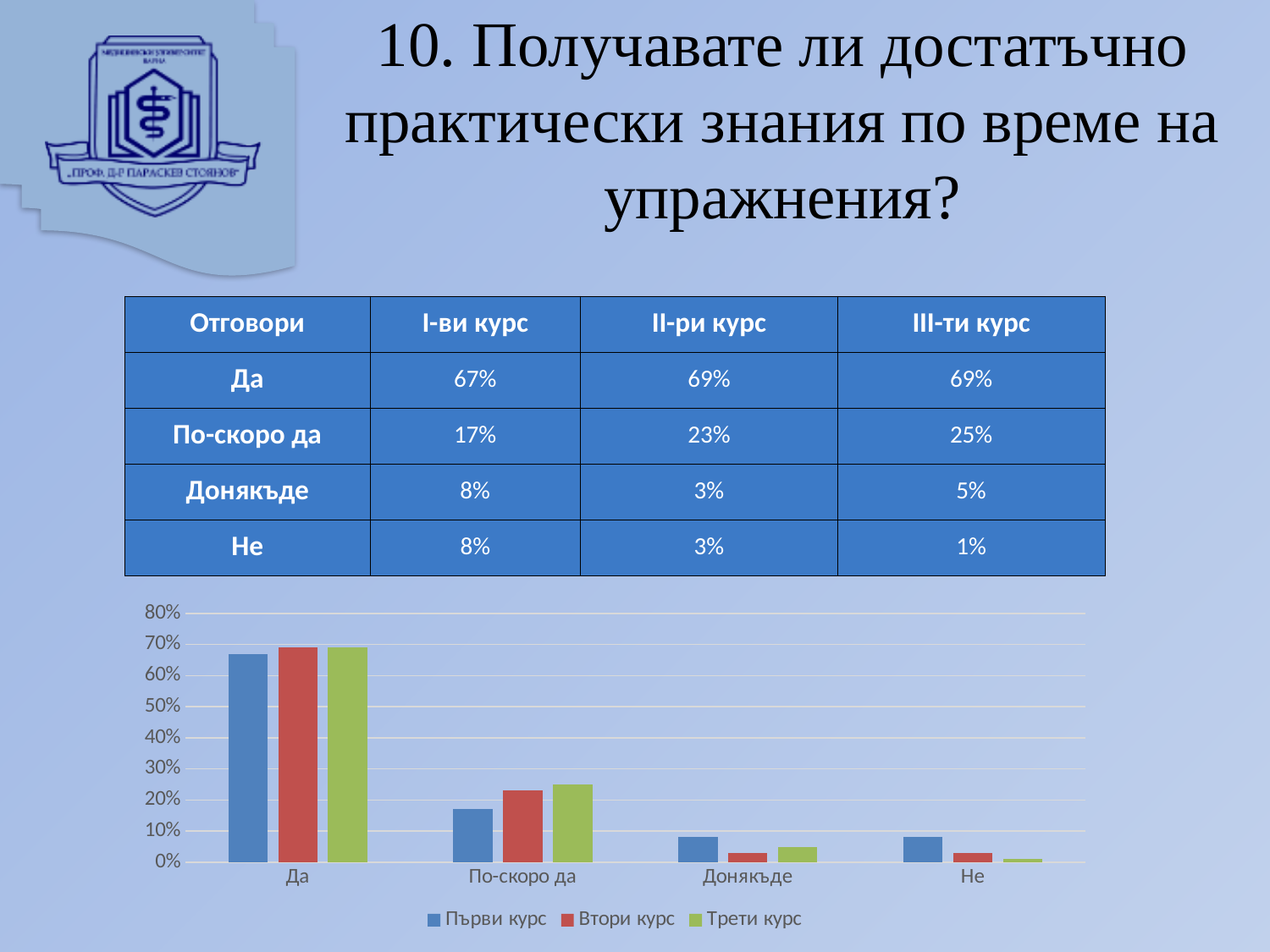
What is the difference between the "По-скоро да" values for II-ри курс and I-ви курс in the table? 6% Which answer category has the highest values in the chart? Да In the chart, is the "По-скоро да" bar for Първи курс greater or less than 20%? less According to the table, what is the value for "Не" for II-ри курс? 3% How many answer categories are shown on the x axis of the chart? 4 According to the table, what is the value for "Да" for I-ви курс? 67% Do the bar values rise or fall moving from "Да" to "Не" along the x axis? fall In the chart, which is larger for "Донякъде": Първи курс or Втори курс? Първи курс What kind of chart is shown on the slide? bar chart According to the table, what is the value for "По-скоро да" for III-ти курс? 25% Which series has the lowest value for "Не" in the chart? Трети курс How many series does the chart legend list? 3